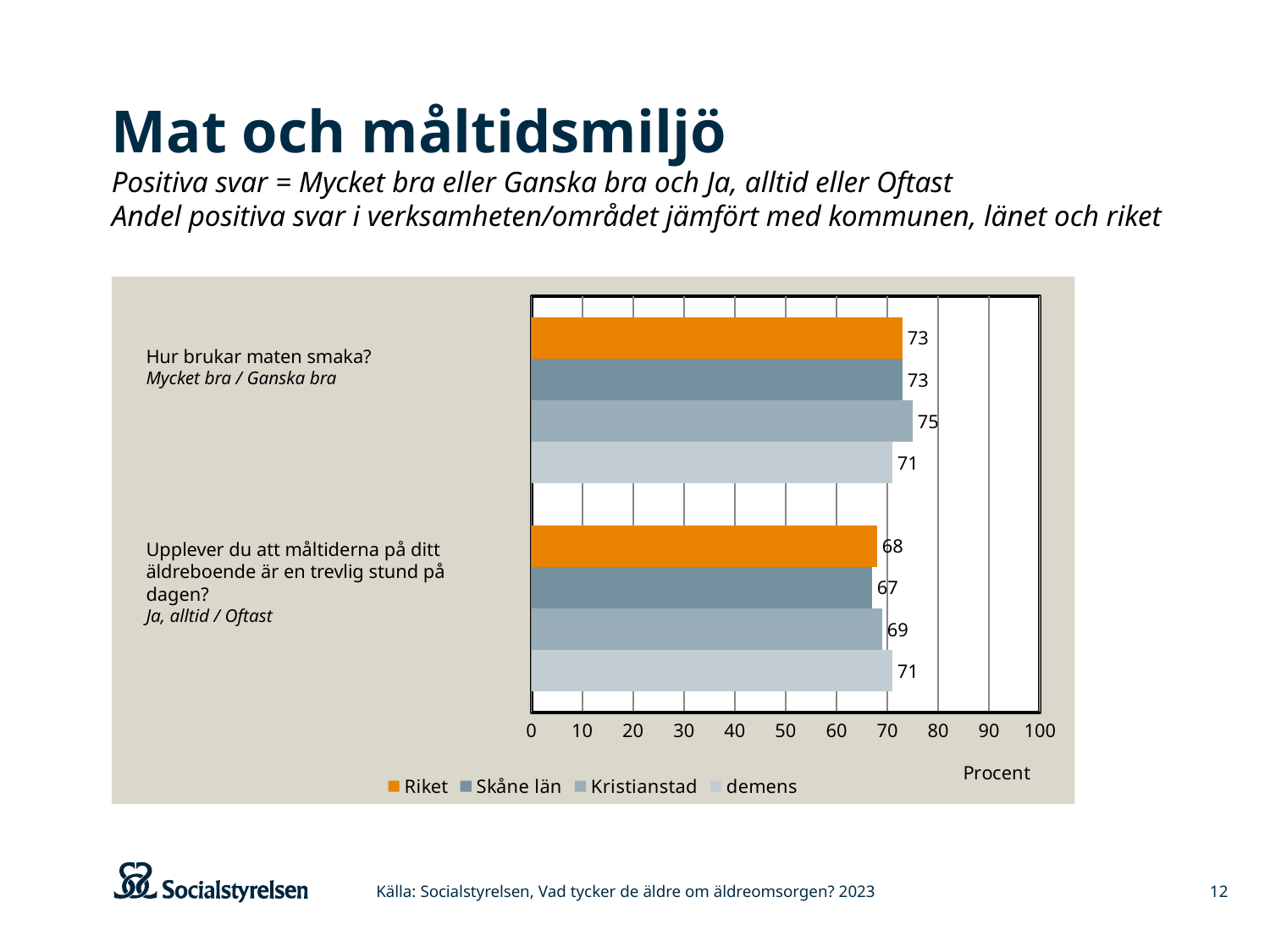
What is the value for Skåne län for the question "Hur brukar maten smaka?"? 73 What is the value for demens for the question "Upplever du att måltiderna på ditt äldreboende är en trevlig stund på dagen?"? 71 What is the difference between the Kristianstad value and the demens value for the question "Hur brukar maten smaka?"? 4 How many questions (categories) are shown on the chart? 2 Which series has the lowest value for the question "Upplever du att måltiderna på ditt äldreboende är en trevlig stund på dagen?"? Skåne län For the question "Upplever du att måltiderna på ditt äldreboende är en trevlig stund på dagen?", which is larger: the value for demens or the value for Riket? demens What is the value for Riket for the question "Upplever du att måltiderna på ditt äldreboende är en trevlig stund på dagen?"? 68 What type of chart is shown on the slide? bar chart What label is shown on the horizontal axis of the chart? Procent How many series does the legend list? 4 Which series has the highest value for the question "Hur brukar maten smaka?"? Kristianstad What is the value for Kristianstad for the question "Hur brukar maten smaka?"? 75